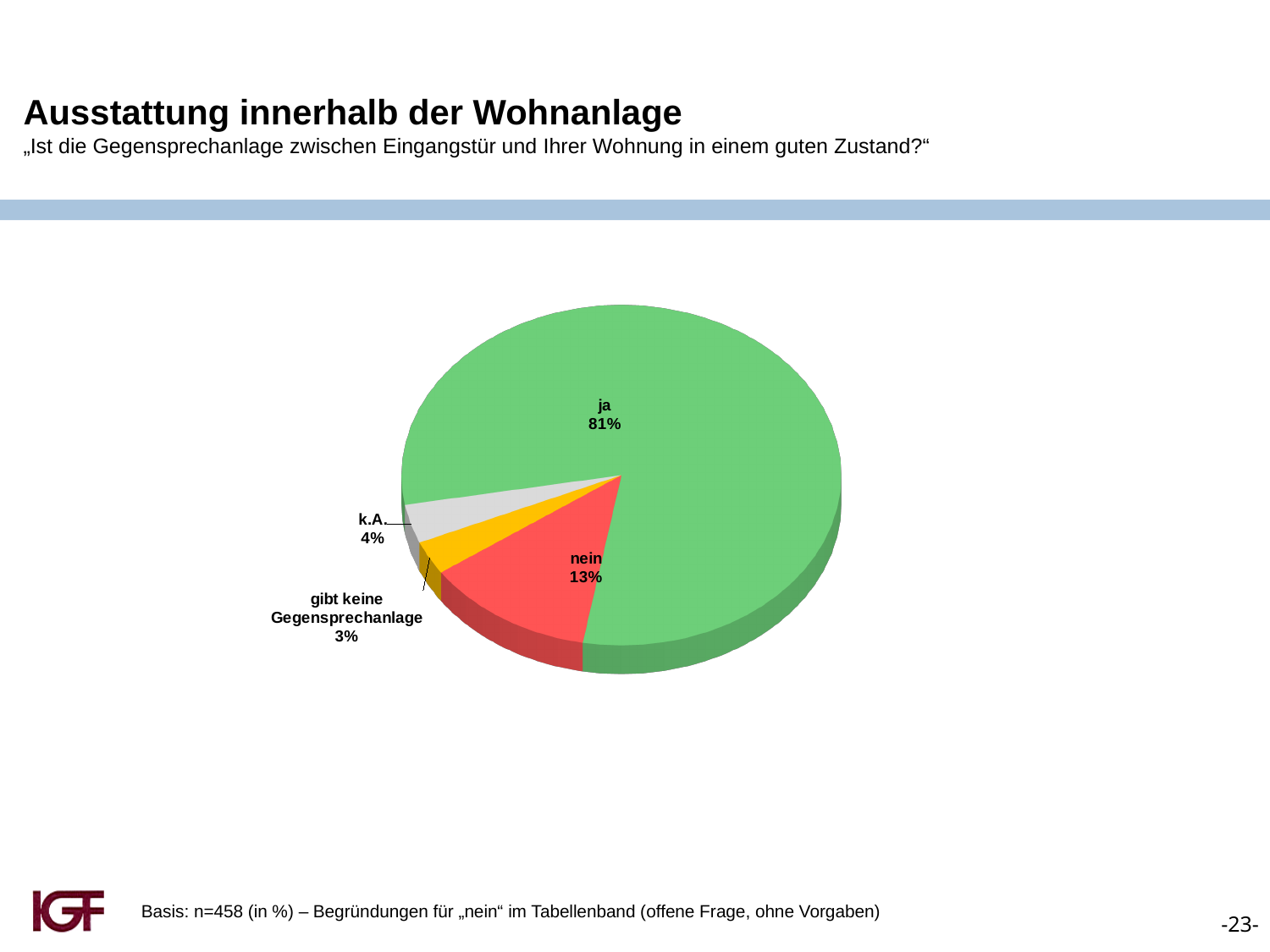
What type of chart is shown on the slide? pie chart What share of the pie is labelled "k.A."? 4% Which is larger, the share for "nein" or the share for "k.A."? nein How many slices does the pie chart have? 4 Which category has the largest share of the pie? ja What is the sample size (n) given in the footnote below the chart? n=458 What percentage of respondents answered "ja"? 81% What percentage of respondents answered "nein"? 13% What percentage is shown for "gibt keine Gegensprechanlage"? 3% Which category has the smallest share of the pie? gibt keine Gegensprechanlage What colour is the "nein" slice? red What is the difference in percentage points between "ja" and "nein"? 68